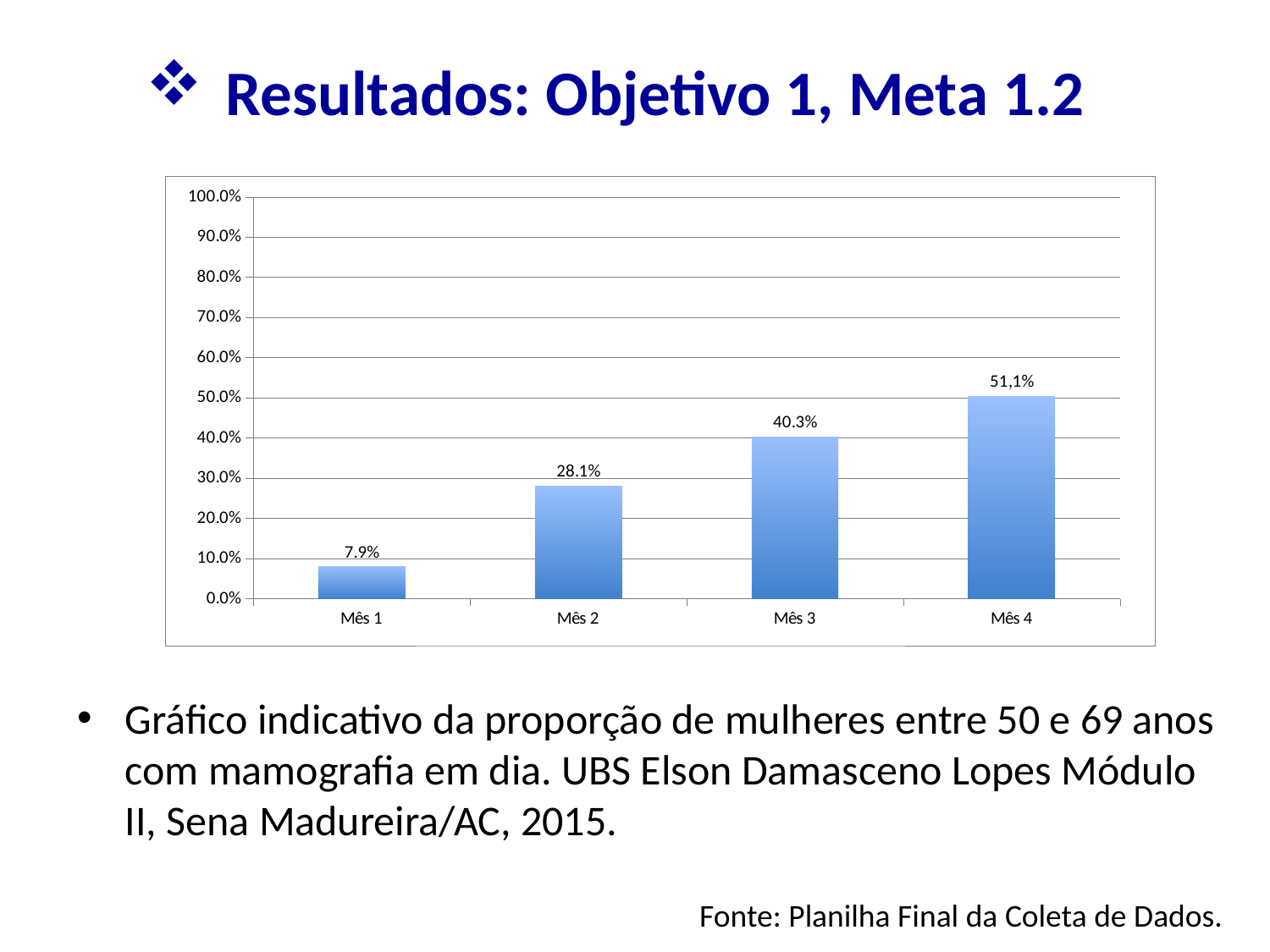
What is the value for Mês 1? 7.9% Which month has the highest value? Mês 4 Do the values rise or fall from Mês 1 to Mês 4? rise Is the value for Mês 4 greater or less than 50.0%? greater How many months are shown on the x axis? 4 What is the difference between the values for Mês 3 and Mês 2? 12.2% What is the maximum value shown on the y axis? 100.0% Which is larger, the value for Mês 2 or the value for Mês 3? Mês 3 Which month has the lowest value? Mês 1 What is the value for Mês 3? 40.3% What is the value for Mês 4? 51,1% What kind of chart is shown on the slide? bar chart